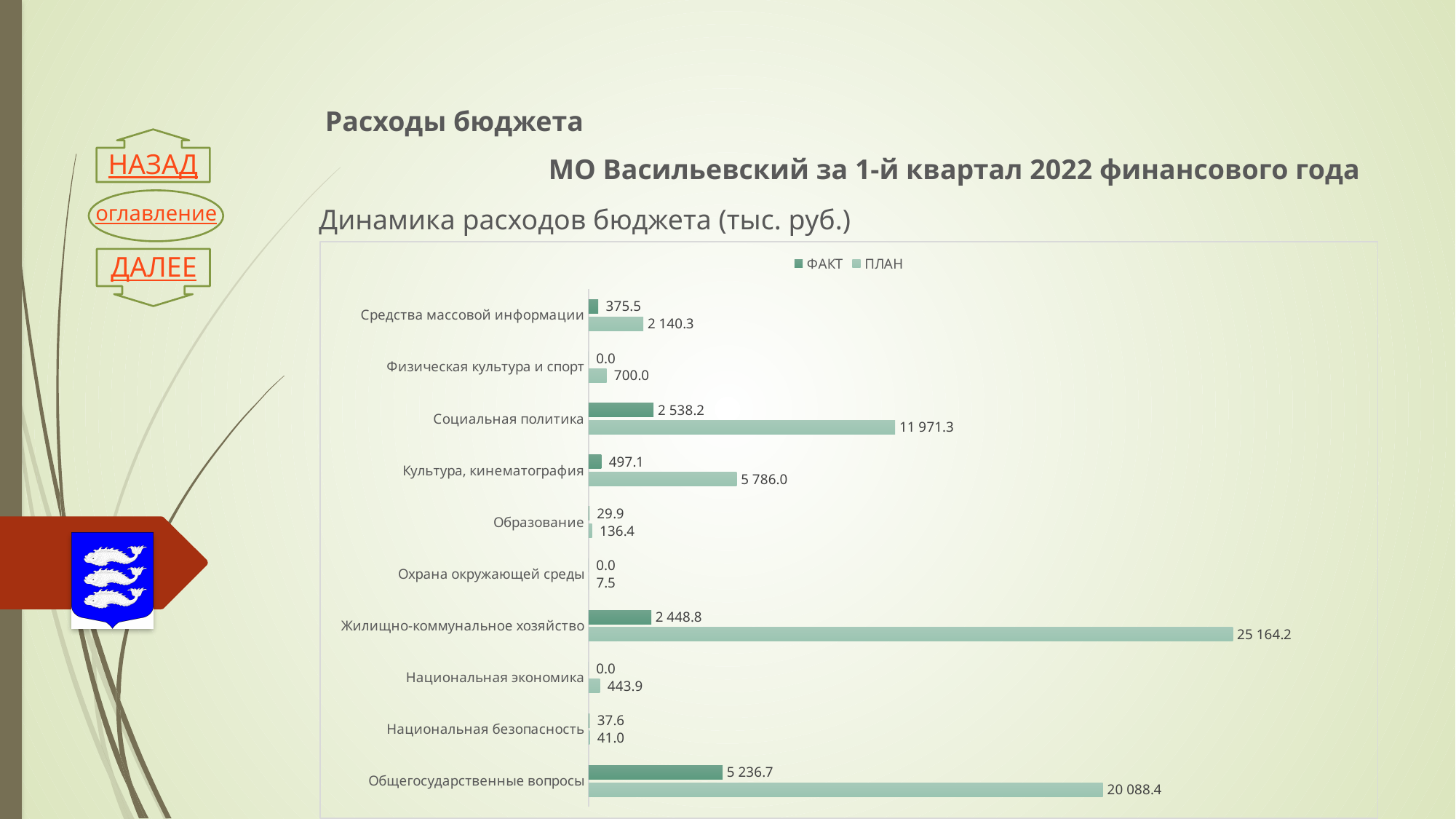
Which category has the highest ФАКТ value? Общегосударственные вопросы What is the ФАКТ value for Национальная безопасность? 37.6 Which category has the lowest ПЛАН value? Охрана окружающей среды What kind of chart is shown on the slide? Bar chart How many series does the legend list? 2 What is the difference between the ПЛАН and ФАКТ values for Социальная политика? 9 433.1 What is the ПЛАН value for Жилищно-коммунальное хозяйство? 25 164.2 Which is larger: the ПЛАН value for Общегосударственные вопросы or the ПЛАН value for Социальная политика? Общегосударственные вопросы Which category has the highest ПЛАН value? Жилищно-коммунальное хозяйство What is the ФАКТ value for Социальная политика? 2 538.2 What is the ПЛАН value for Культура, кинематография? 5 786.0 How many categories are shown in the chart? 10